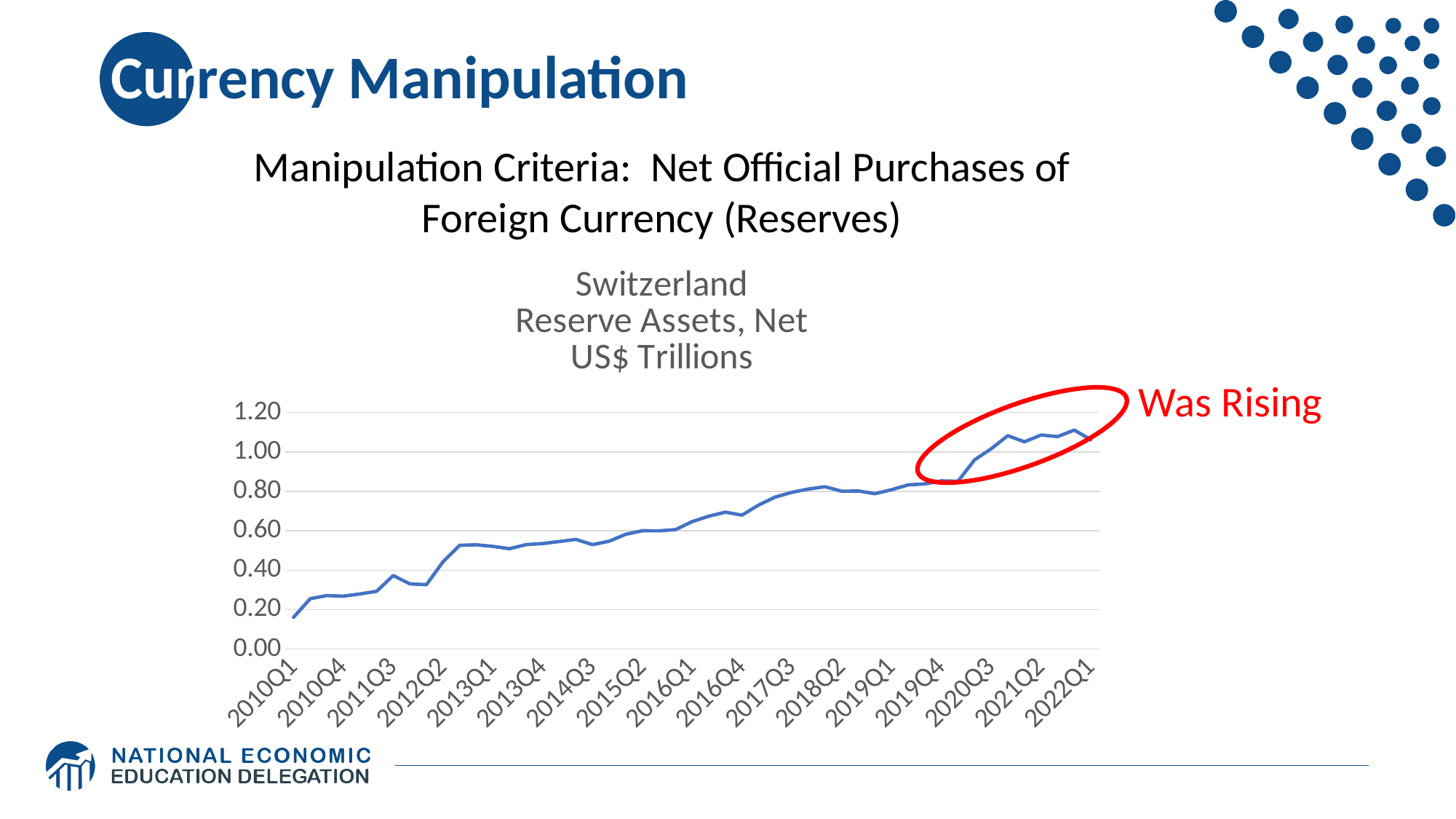
Overall, do the values rise or fall from 2010Q1 to 2022Q1? Rise Which country's reserve assets does the chart show? Switzerland What kind of chart is shown on the slide? Line chart Is the value for 2011Q3 greater or less than 0.40? less What does the red annotation next to the circled part of the line say? Was Rising Is the value for 2021Q2 greater or less than 1.00? greater How many quarter labels are shown on the x axis? 17 Is the value for 2022Q1 greater or less than 1.00? greater Which is larger, the value for 2022Q1 or the value for 2010Q1? 2022Q1 Which quarter has the lowest value on the chart? 2010Q1